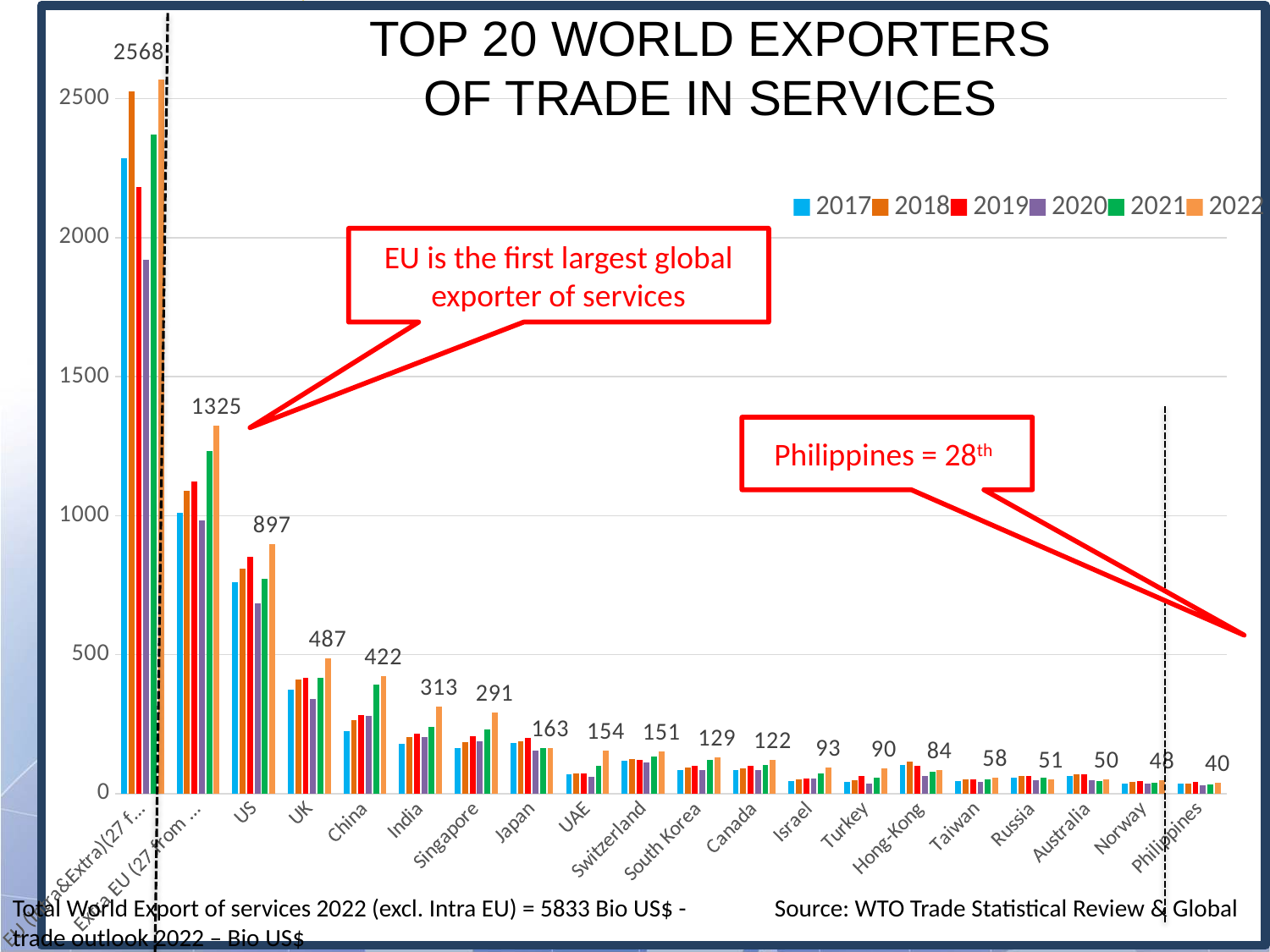
Which category has the highest labelled value on the chart? EU (Intra&Extra) What kind of chart is shown on the slide? bar chart How many countries or regions are shown along the x axis? 20 What is the labelled 2022 value for Singapore? 291 What is the labelled 2022 value for the US? 897 Which has the larger labelled 2022 value, China or India? China What is the difference between the labelled 2022 values for the US and the UK? 410 Do the labelled values generally rise or fall moving from left to right along the x axis? fall Which category has the lowest labelled value on the chart? Philippines Is the 2017 value for the US greater or less than 500? greater How many series does the legend list? 6 What is the labelled 2022 value for the Philippines? 40